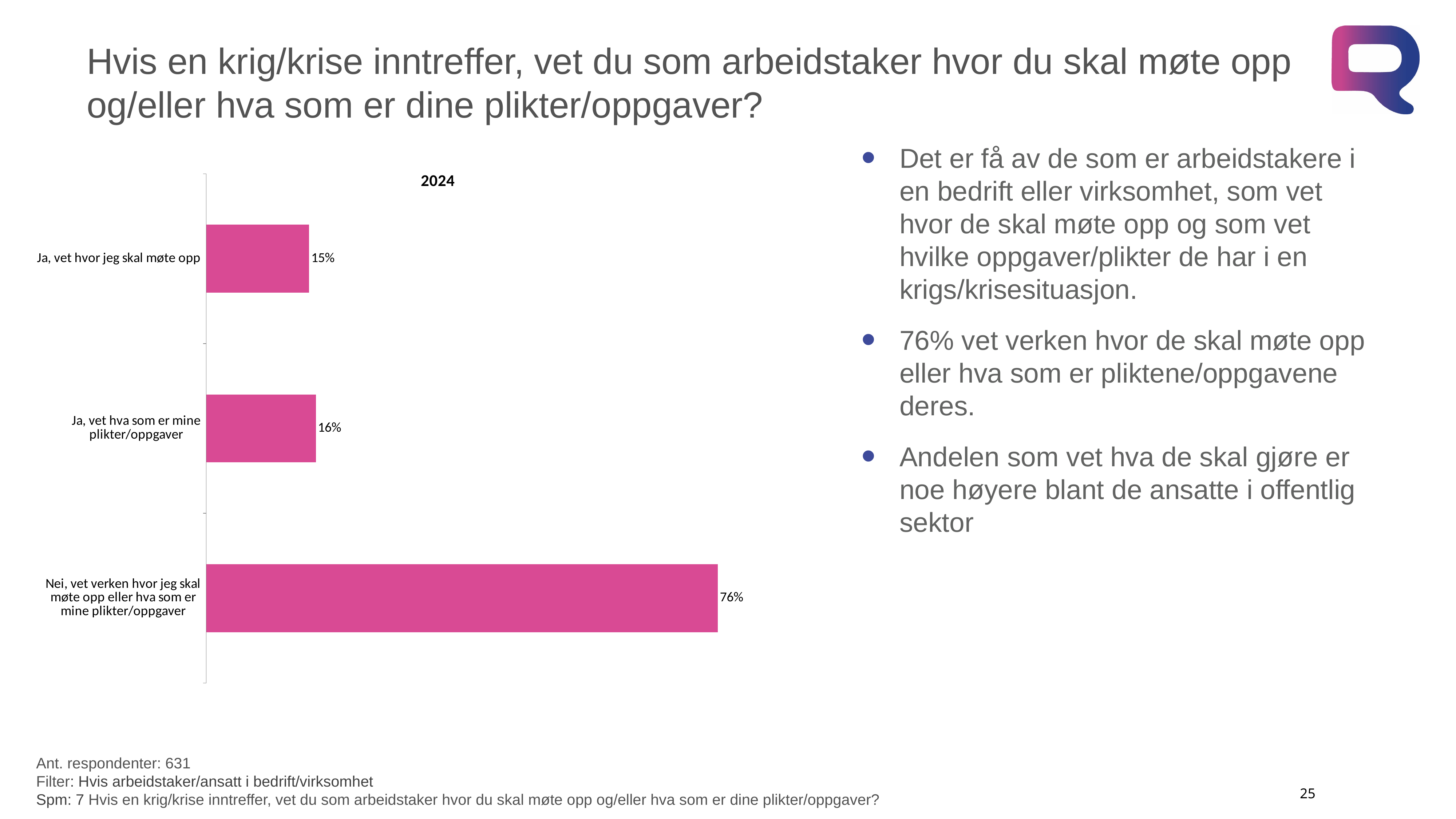
Which category has the lowest value in the chart? Ja, vet hvor jeg skal møte opp Which category has the highest value in the chart? Nei, vet verken hvor jeg skal møte opp eller hva som er mine plikter/oppgaver What percentage of respondents answered "Ja, vet hvor jeg skal møte opp"? 15% What is the difference between the values for "Ja, vet hva som er mine plikter/oppgaver" and "Ja, vet hvor jeg skal møte opp"? 1 percentage point What is the difference between the value for "Nei, vet verken hvor jeg skal møte opp eller hva som er mine plikter/oppgaver" and the value for "Ja, vet hva som er mine plikter/oppgaver"? 60 percentage points What is the title shown above the chart? 2024 What is the value shown for "Ja, vet hva som er mine plikter/oppgaver"? 16% What percentage answered "Nei, vet verken hvor jeg skal møte opp eller hva som er mine plikter/oppgaver"? 76% What colour are the bars in the chart? Pink How many categories are shown in the chart? 3 Which is larger: the value for "Ja, vet hva som er mine plikter/oppgaver" or the value for "Nei, vet verken hvor jeg skal møte opp eller hva som er mine plikter/oppgaver"? Nei, vet verken hvor jeg skal møte opp eller hva som er mine plikter/oppgaver What kind of chart is shown on the slide? Bar chart